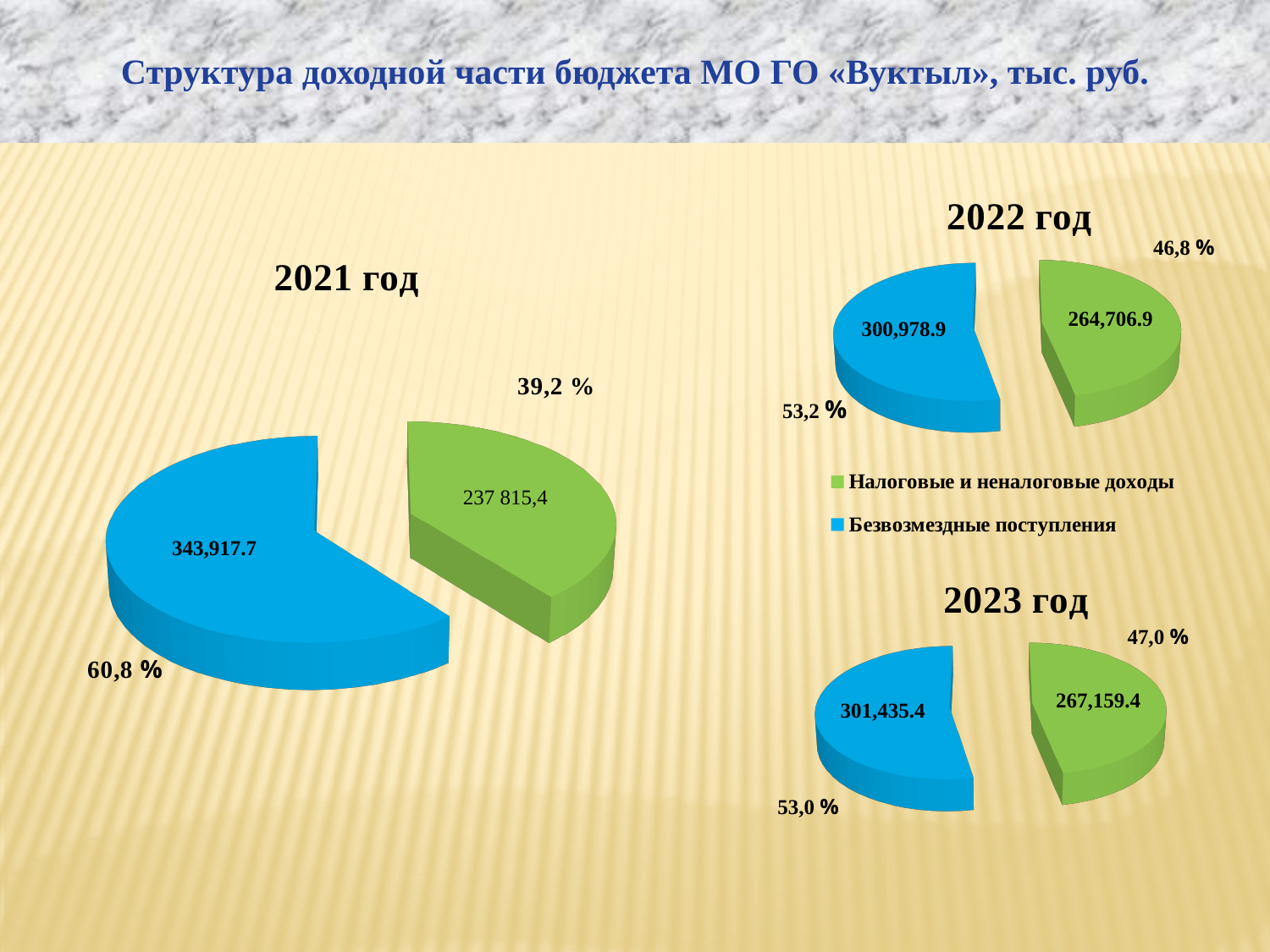
In the 2021 год chart, what is the value for Налоговые и неналоговые доходы? 237 815,4 What type of charts are shown on the slide? Pie charts In the 2022 год chart, what share of the pie is Налоговые и неналоговые доходы? 46,8 % In the 2022 год chart, what is the value for Налоговые и неналоговые доходы? 264,706.9 In the 2021 год chart, what share of the pie is Безвозмездные поступления? 60,8 % Which colour represents Безвозмездные поступления in the legend? Blue In the 2023 год chart, which slice is larger, Налоговые и неналоговые доходы or Безвозмездные поступления? Безвозмездные поступления In the 2021 год chart, what is the value for Безвозмездные поступления? 343,917.7 In the 2023 год chart, what is the value for Безвозмездные поступления? 301,435.4 In the 2022 год chart, what is the difference between Безвозмездные поступления and Налоговые и неналоговые доходы? 36,272.0 How many pie charts are on the slide? 3 How many series does the legend list? 2